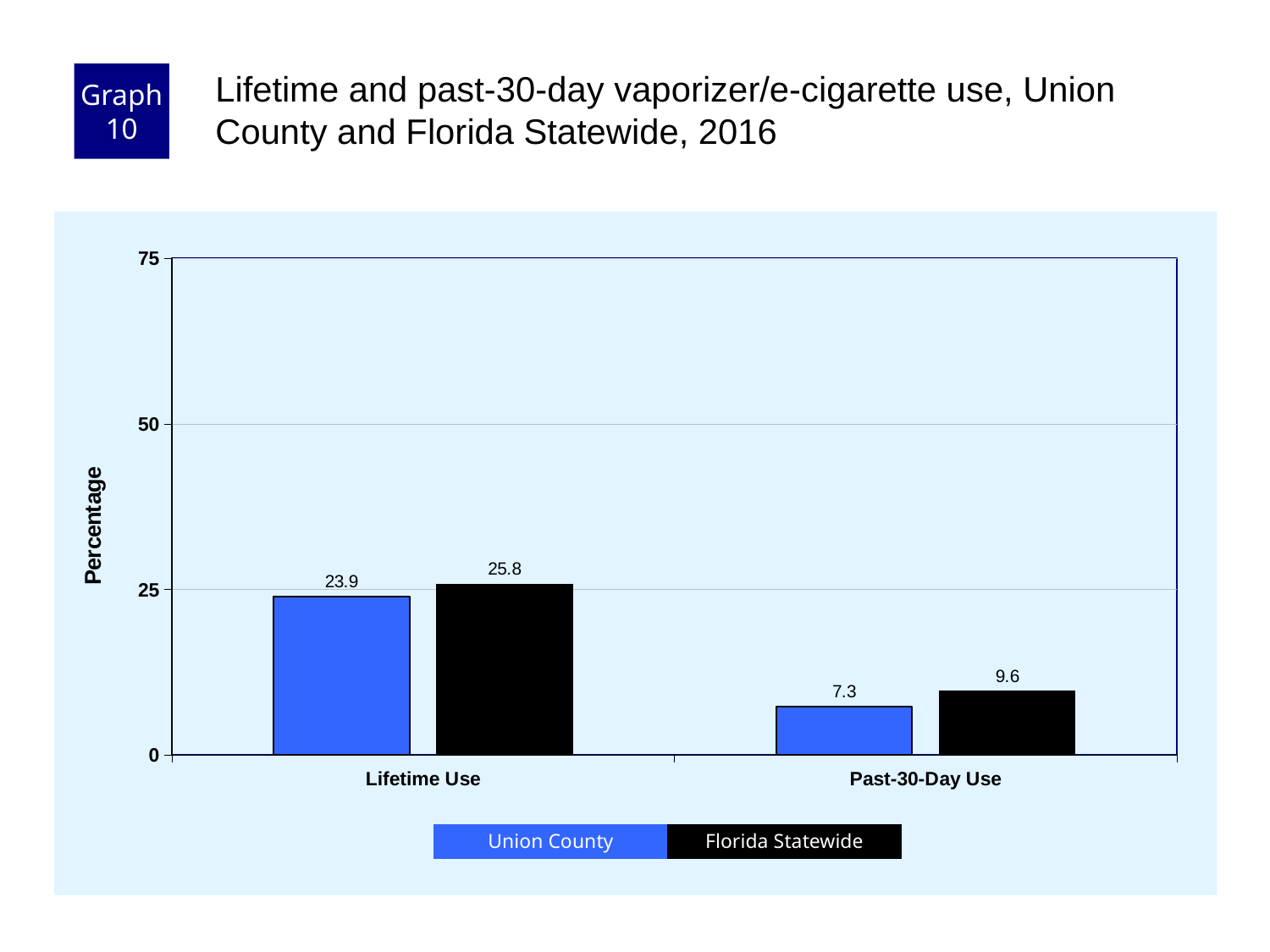
What is the Union County value for Lifetime Use? 23.9 How many series does the legend list? 2 Which bar has the lowest value on the chart? Union County, Past-30-Day Use What is the Florida Statewide value for Past-30-Day Use? 9.6 For Past-30-Day Use, which is larger: Union County or Florida Statewide? Florida Statewide What is the difference between the Florida Statewide and Union County values for Lifetime Use? 1.9 What is the difference between the Florida Statewide and Union County values for Past-30-Day Use? 2.3 What kind of chart is shown on the slide? Bar chart What is the Union County value for Past-30-Day Use? 7.3 Which bar has the highest value on the chart? Florida Statewide, Lifetime Use Is the Florida Statewide value for Lifetime Use greater or less than 25? greater What is the Florida Statewide value for Lifetime Use? 25.8